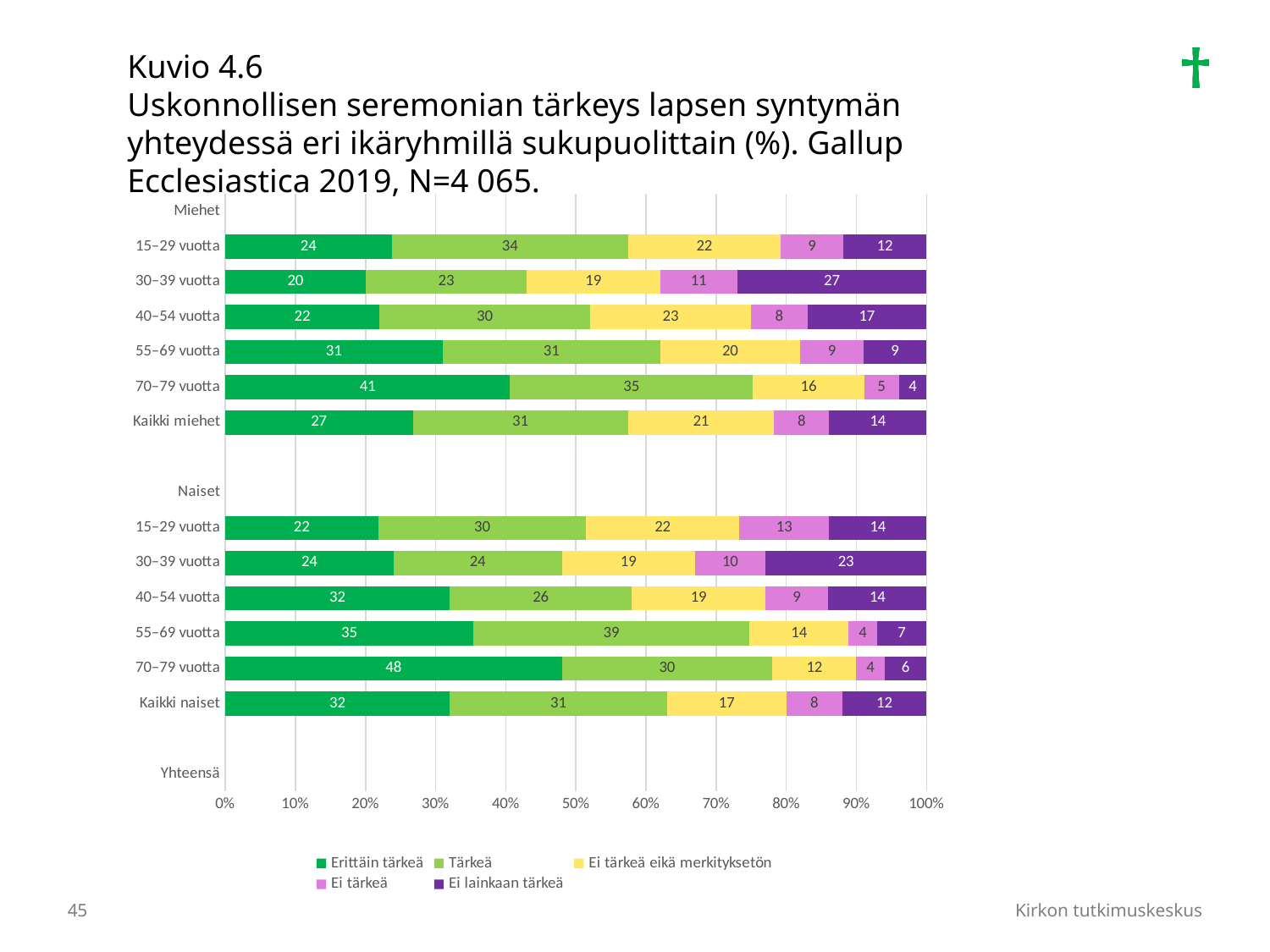
What is the 'Ei lainkaan tärkeä' value for women (Naiset) aged 30–39 vuotta? 23 What is the total of the stacked bar for women (Naiset) aged 70–79 vuotta? 100 What is the 'Tärkeä' value for Kaikki naiset? 31 What is the 'Erittäin tärkeä' value for men (Miehet) aged 70–79 vuotta? 41 What is the 'Ei tärkeä' value for women (Naiset) aged 15–29 vuotta? 13 What kind of chart is shown on the slide? Stacked bar chart Which legend entry is shown in yellow? Ei tärkeä eikä merkityksetön How many series does the legend list? 5 Which is larger: the 'Ei lainkaan tärkeä' value for men aged 30–39 vuotta or for women aged 30–39 vuotta? Men aged 30–39 vuotta What is the difference between the 'Erittäin tärkeä' values for Kaikki naiset and Kaikki miehet? 5 Which men's (Miehet) age group has the lowest 'Erittäin tärkeä' value? 30–39 vuotta Which group has the highest 'Erittäin tärkeä' value? Naiset 70–79 vuotta